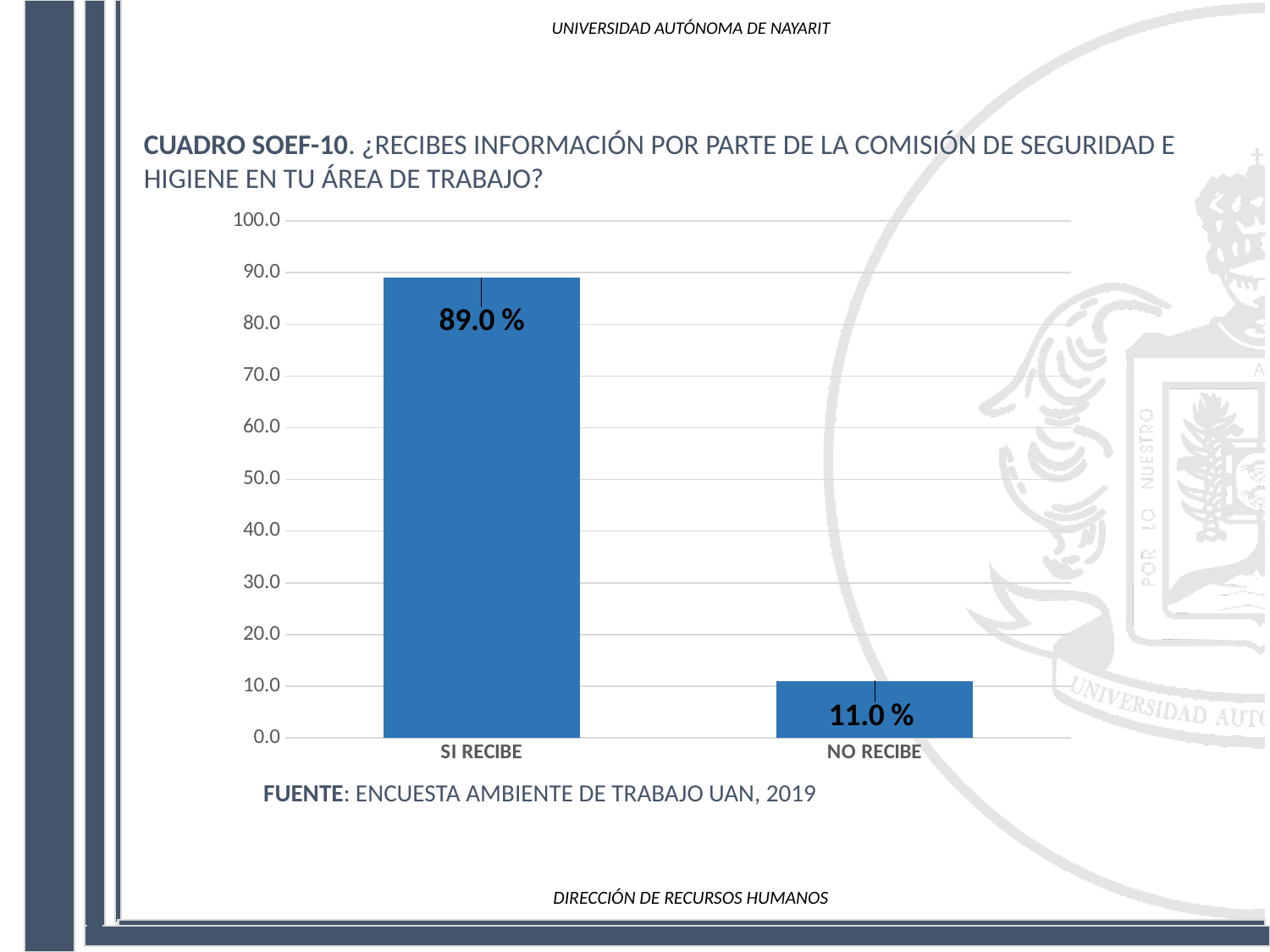
Which category has the highest value? SI RECIBE How many categories are shown on the x axis? 2 Is the value for NO RECIBE greater or less than 20.0? less What is the difference between the values for SI RECIBE and NO RECIBE? 78.0 % Which is larger, the value for SI RECIBE or the value for NO RECIBE? SI RECIBE What is the value for NO RECIBE? 11.0 % Is the value for SI RECIBE greater or less than 80.0? greater What is the value for SI RECIBE? 89.0 % What kind of chart is shown on the slide? bar chart Which category has the lowest value? NO RECIBE What source is cited below the chart? ENCUESTA AMBIENTE DE TRABAJO UAN, 2019 What is the total of the two values shown in the chart? 100.0 %